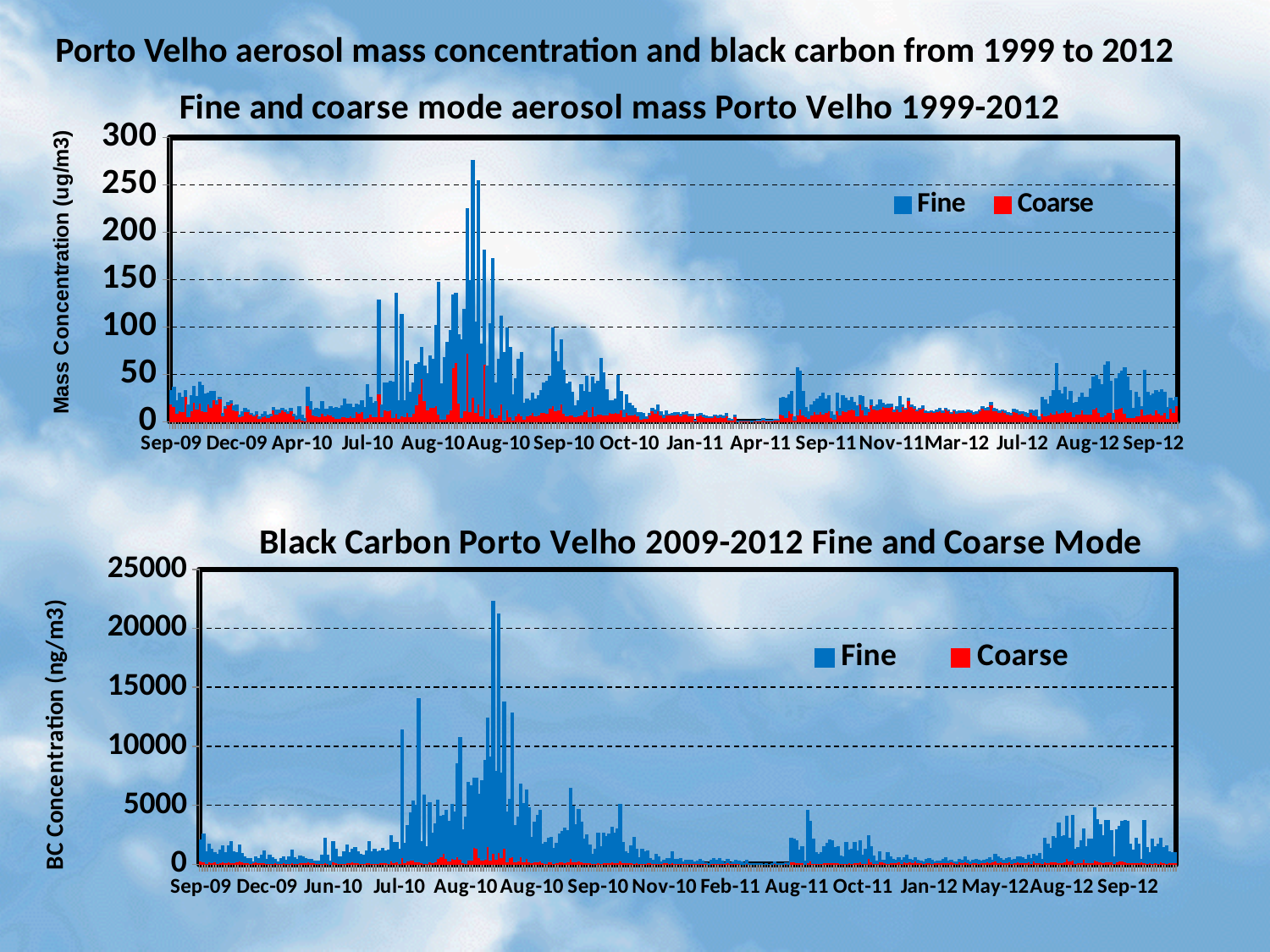
In the top chart, which series reaches higher values overall, Fine or Coarse? Fine What is the y-axis label of the bottom chart, 'Black Carbon Porto Velho 2009-2012 Fine and Coarse Mode'? BC Concentration (ng/m3) What kind of chart is the top chart, 'Fine and coarse mode aerosol mass Porto Velho 1999-2012'? Bar chart In the bottom chart, what is the maximum value shown on the y-axis? 25000 In the bottom chart, is the highest Fine peak (around Aug-10) greater or less than 20000? greater In the bottom chart, 'Black Carbon Porto Velho 2009-2012 Fine and Coarse Mode', which series reaches higher values overall, Fine or Coarse? Fine In the top chart, is the Fine value around Jan-11 greater or less than 50? less In the top chart, 'Fine and coarse mode aerosol mass Porto Velho 1999-2012', how many series does the legend list? 2 In the bottom chart, 'Black Carbon Porto Velho 2009-2012 Fine and Coarse Mode', what are the two series named in the legend? Fine and Coarse In the bottom chart, is the Fine value around Feb-11 greater or less than 5000? less In the top chart, what is the maximum value shown on the y-axis? 300